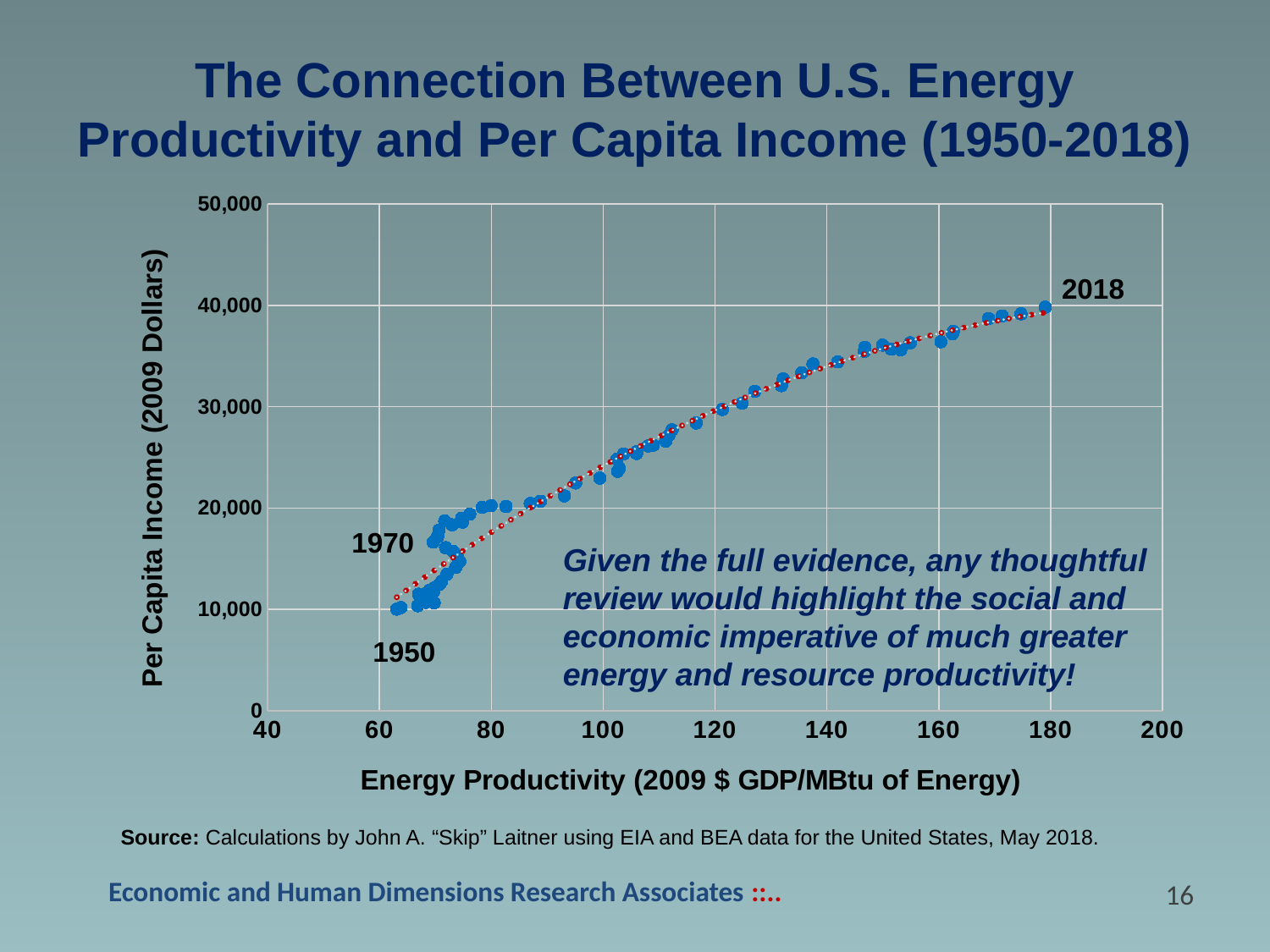
Is the energy productivity for the point labeled 2018 greater or less than 160? greater Is the per capita income for the point labeled 1970 greater or less than 20,000? less Is the per capita income for the point labeled 1950 greater or less than 20,000? less Which labeled year has the higher per capita income, 1970 or 2018? 2018 Does per capita income generally rise or fall as energy productivity increases along the x axis? rise What is the title of the x axis? Energy Productivity (2009 $ GDP/MBtu of Energy) What kind of chart is shown on the slide? scatter chart Of the labeled years 1950, 1970 and 2018, which has the lowest energy productivity? 1950 What is the title of the y axis? Per Capita Income (2009 Dollars) Of the labeled years 1950, 1970 and 2018, which has the highest per capita income? 2018